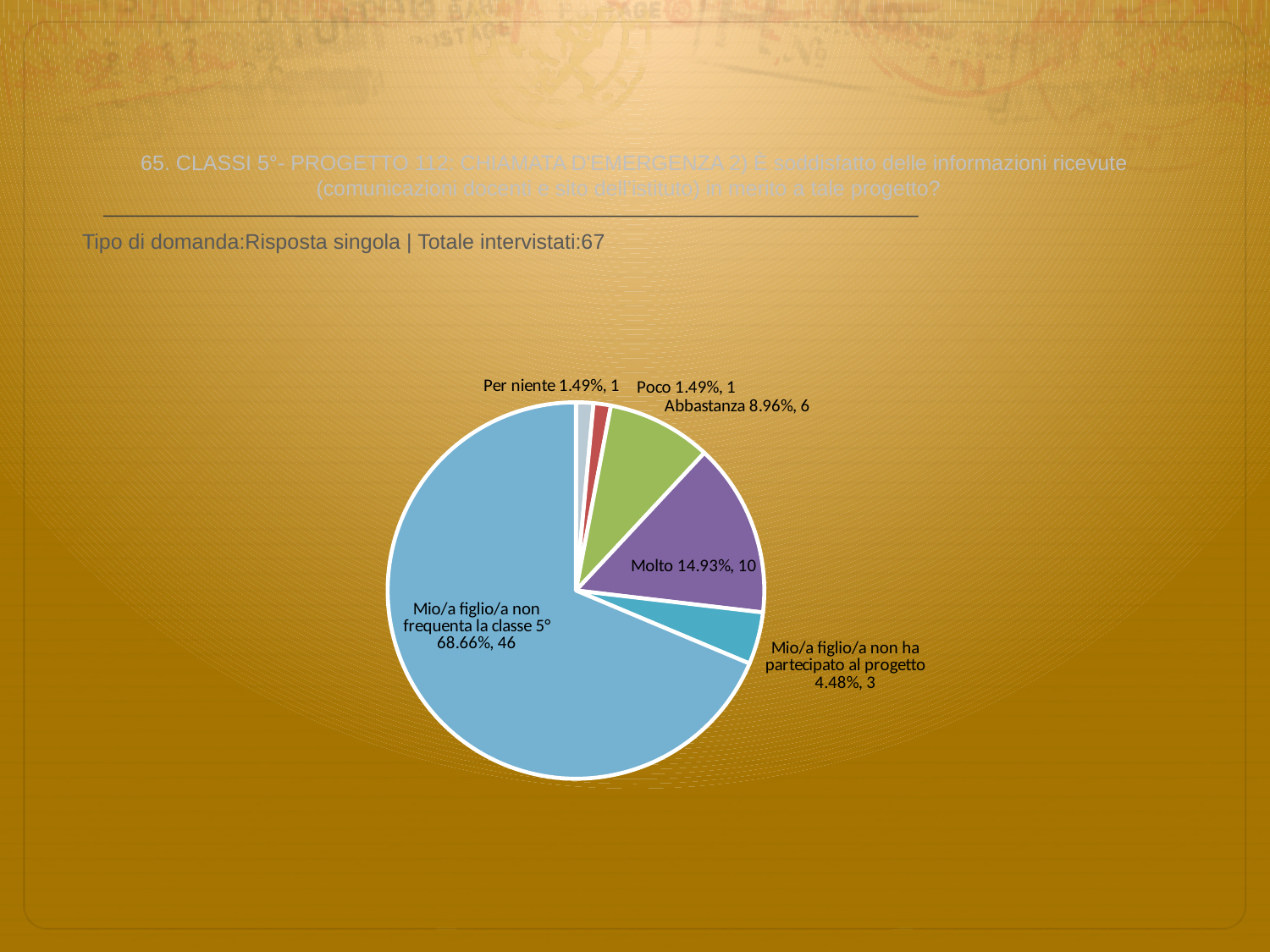
What is the total number of respondents stated on the slide? 67 What percentage share does "Mio/a figlio/a non ha partecipato al progetto" have? 4.48% What is the count for "Molto"? 10 What percentage share does "Abbastanza" have? 8.96% How many slices does the pie chart have? 6 What is the difference in count between "Molto" and "Abbastanza"? 4 What is the count for "Mio/a figlio/a non frequenta la classe 5°"? 46 What is the count for "Per niente"? 1 Which category has the largest slice? Mio/a figlio/a non frequenta la classe 5° Which is larger, the count for "Abbastanza" or the count for "Mio/a figlio/a non ha partecipato al progetto"? Abbastanza What percentage share does "Poco" have? 1.49% What kind of chart is shown on the slide? pie chart